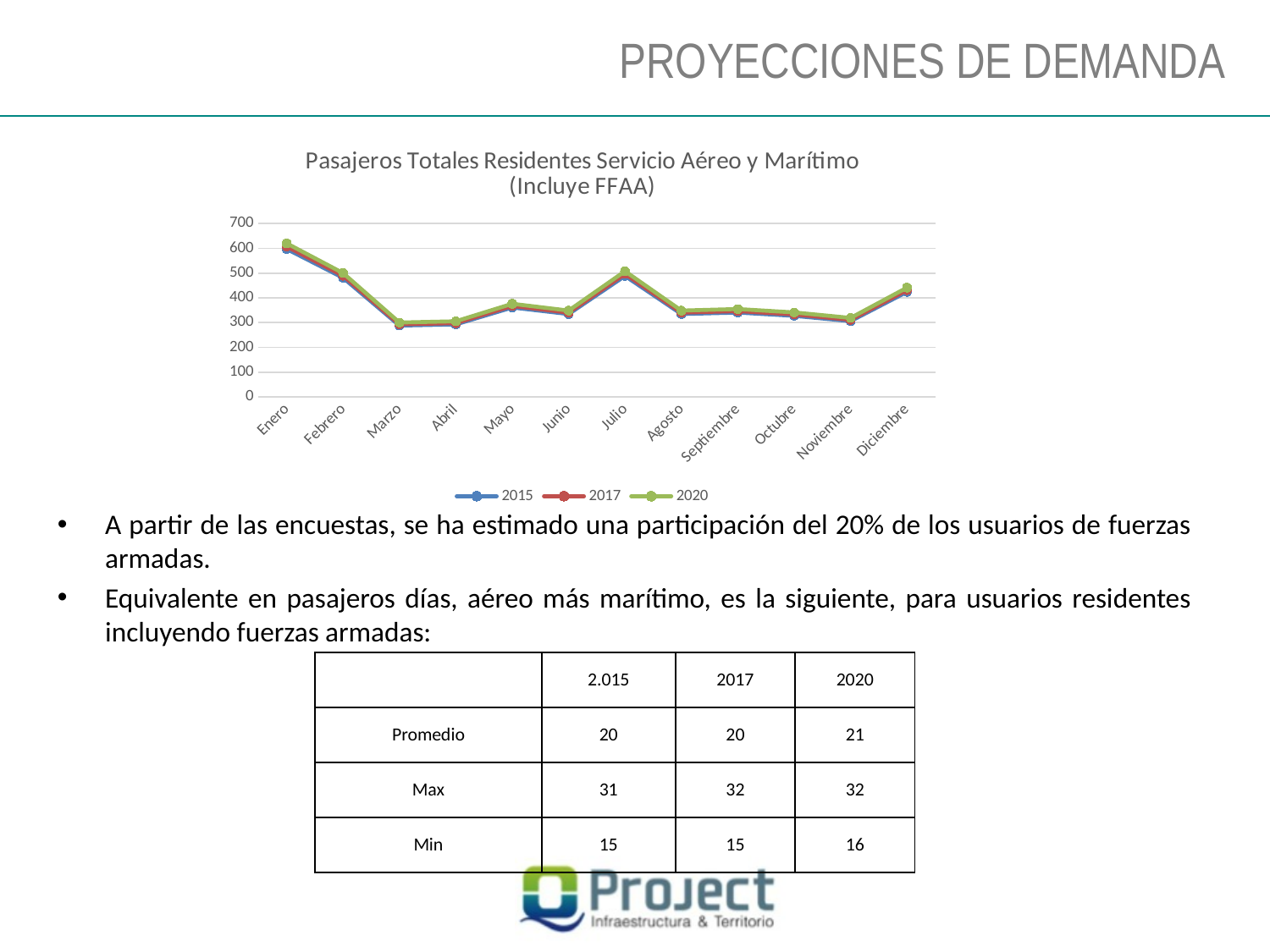
How many months are plotted along the x axis of the chart? 12 Is the value for Octubre in the 2017 series greater or less than 400? less Which month has the highest value for the 2020 series? Enero For the 2020 series, which is larger: the value for Enero or the value for Julio? Enero Do the values of the 2015 series rise or fall from Enero to Marzo? fall What is the title of the chart? Pasajeros Totales Residentes Servicio Aéreo y Marítimo (Incluye FFAA) Is the value for Marzo in the 2015 series greater or less than 400? less What kind of chart is shown on the slide? line chart Is the value for Julio in the 2020 series greater or less than 400? greater For the 2017 series, which is larger: the value for Julio or the value for Junio? Julio How many series does the chart legend list? 3